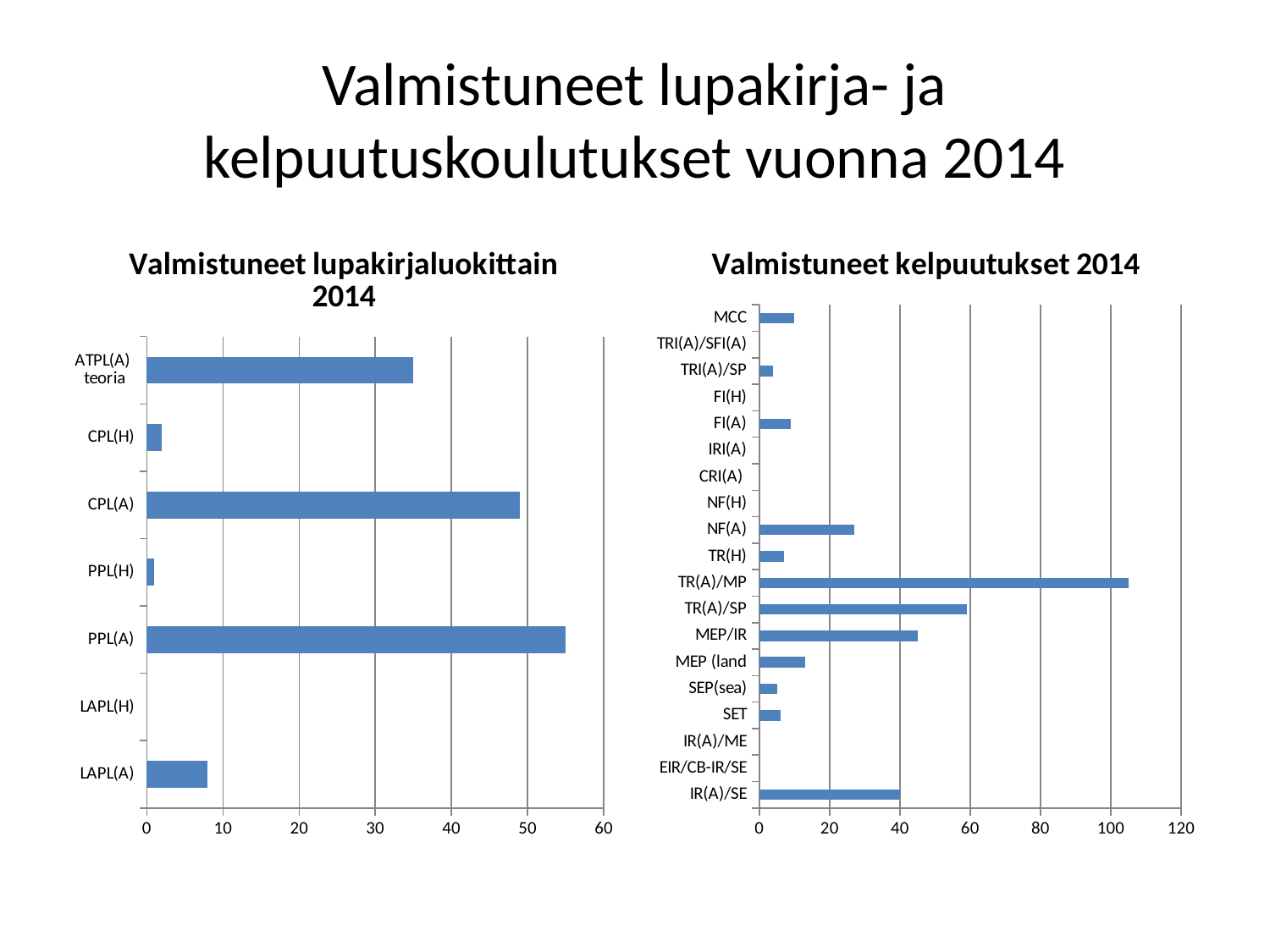
In the chart titled "Valmistuneet lupakirjaluokittain 2014", which category has the highest value? PPL(A) In the chart titled "Valmistuneet lupakirjaluokittain 2014", is the value for CPL(A) greater or less than 40? greater In the chart titled "Valmistuneet kelpuutukset 2014", is the value for NF(A) greater or less than 40? less In the chart titled "Valmistuneet kelpuutukset 2014", which category has the highest value? TR(A)/MP In the chart titled "Valmistuneet kelpuutukset 2014", which is larger, the value for TR(A)/SP or the value for MEP/IR? TR(A)/SP In the chart titled "Valmistuneet lupakirjaluokittain 2014", is the value for LAPL(A) greater or less than 10? less How many categories are shown in the chart titled "Valmistuneet kelpuutukset 2014"? 19 What kind of chart is "Valmistuneet lupakirjaluokittain 2014"? bar chart In the chart titled "Valmistuneet lupakirjaluokittain 2014", which is larger, the value for ATPL(A) teoria or the value for CPL(A)? CPL(A) How many categories are shown in the chart titled "Valmistuneet lupakirjaluokittain 2014"? 7 What is the title of the chart on the right side of the slide? Valmistuneet kelpuutukset 2014